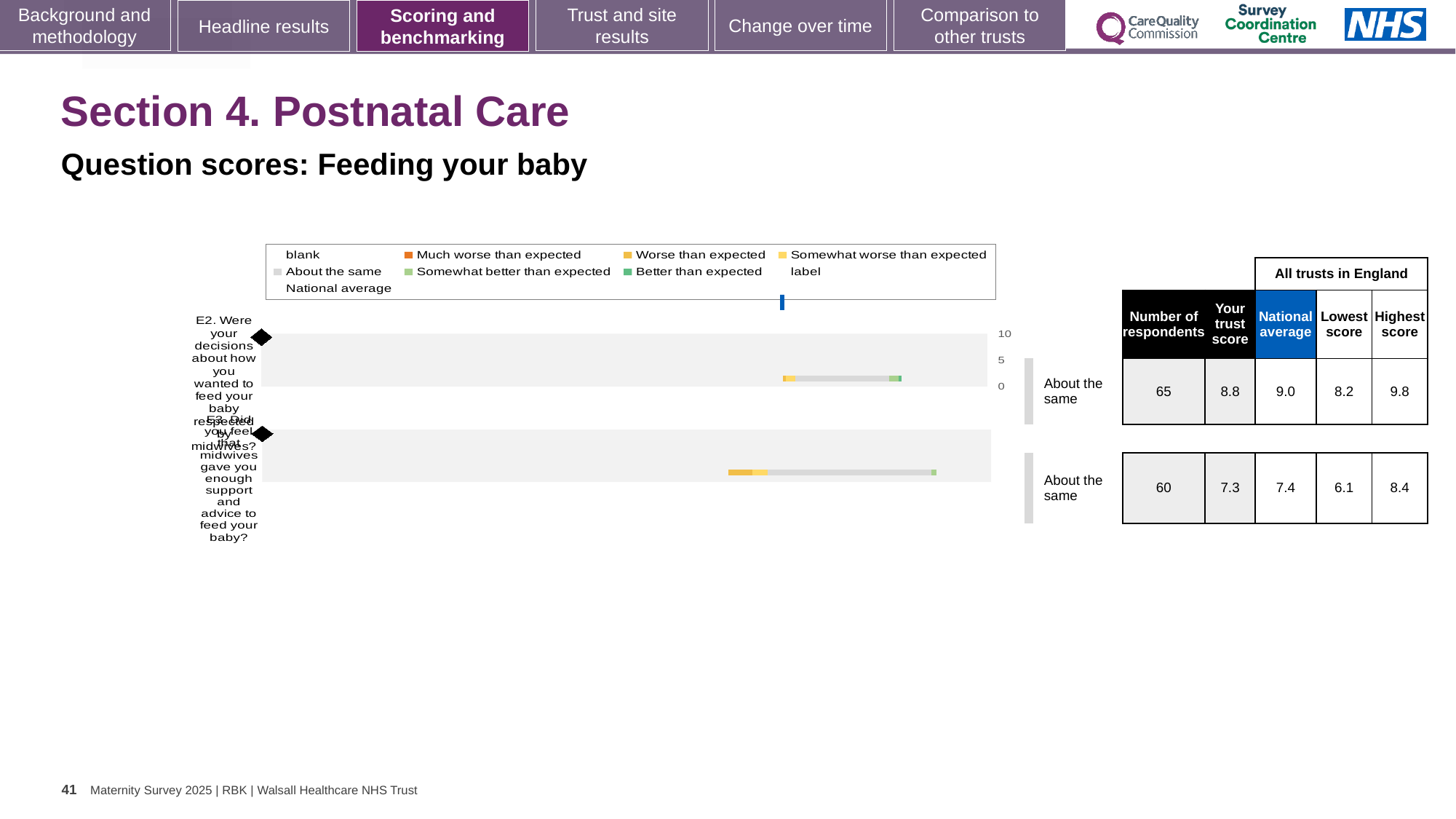
By how much does the national average exceed the trust score for question E2? 0.2 How many respondents answered question E2? 65 What is the difference between the highest score and the lowest score for question E3? 2.3 How many survey questions are plotted in the chart? 2 What kind of chart is shown on the slide? bar chart What is the trust score for question E2 (decisions about how you wanted to feed your baby respected by midwives)? 8.8 What is the national average for question E3 (midwives gave enough support and advice to feed your baby)? 7.4 What is the highest score among all trusts in England for question E2? 9.8 What benchmark category is shown for question E3? About the same For question E2, which is larger: the trust score or the national average? National average Which question has the higher trust score, E2 or E3? E2 What colour represents 'Better than expected' in the legend? Green